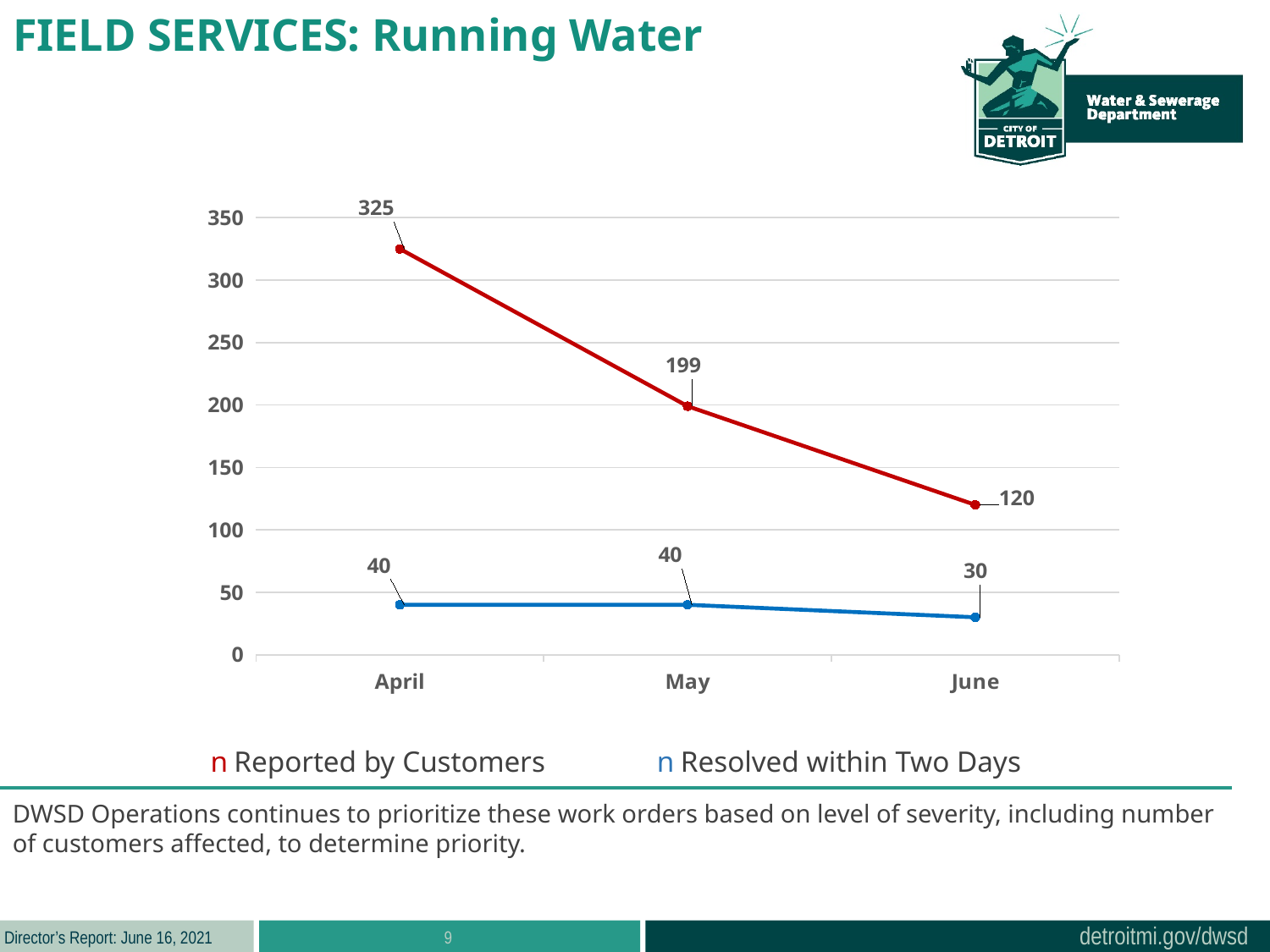
What is the value for Reported by Customers in May? 199 What kind of chart is shown on the slide? Line chart What is the difference between Reported by Customers in April and in June? 205 How many series does the legend list? 2 What is the difference between Reported by Customers and Resolved within Two Days in May? 159 In which month is the Reported by Customers value highest? April In which month is the Resolved within Two Days value lowest? June Does the Reported by Customers series rise or fall from April to June? Fall How many months are shown on the x axis? 3 What is the value for Resolved within Two Days in June? 30 What is the value for Reported by Customers in April? 325 Which is larger in June: Reported by Customers or Resolved within Two Days? Reported by Customers